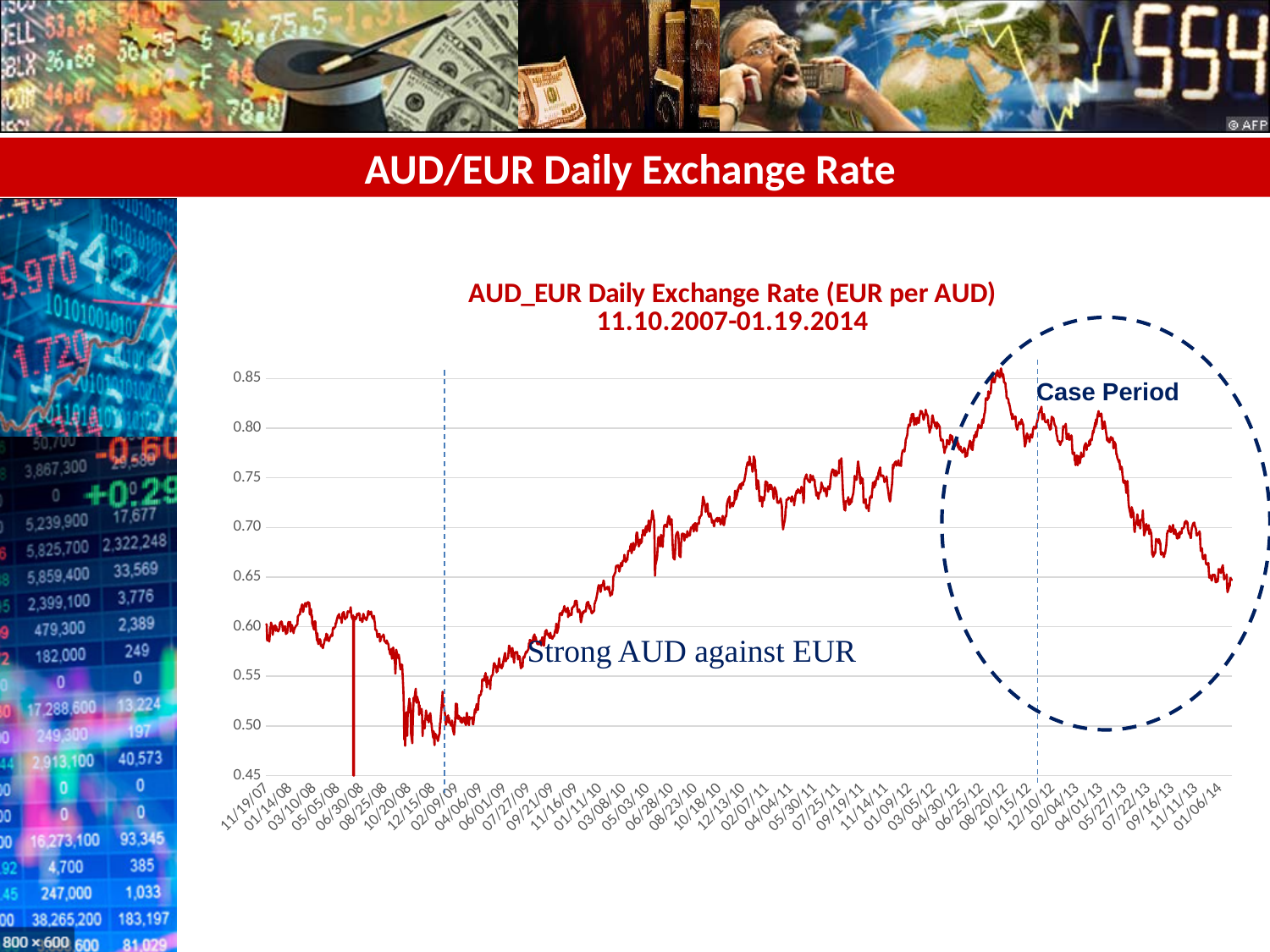
Is the exchange rate at 03/05/12 greater or less than 0.75? greater Does the exchange rate generally rise or fall between 02/09/09 and 03/05/12? rise What is the title of the chart? AUD_EUR Daily Exchange Rate (EUR per AUD) 11.10.2007-01.19.2014 Which is higher, the exchange rate at 12/15/08 or at 03/05/12? 03/05/12 Around which x-axis date does the exchange rate reach its highest value? 08/20/12 What label is written inside the dashed ellipse on the chart? Case Period What kind of chart is shown on the slide? line chart Is the exchange rate at 07/22/13 greater or less than 0.75? less Is the exchange rate at 11/19/07 greater or less than 0.55? greater Does the exchange rate generally rise or fall between 10/15/12 and 01/06/14? fall